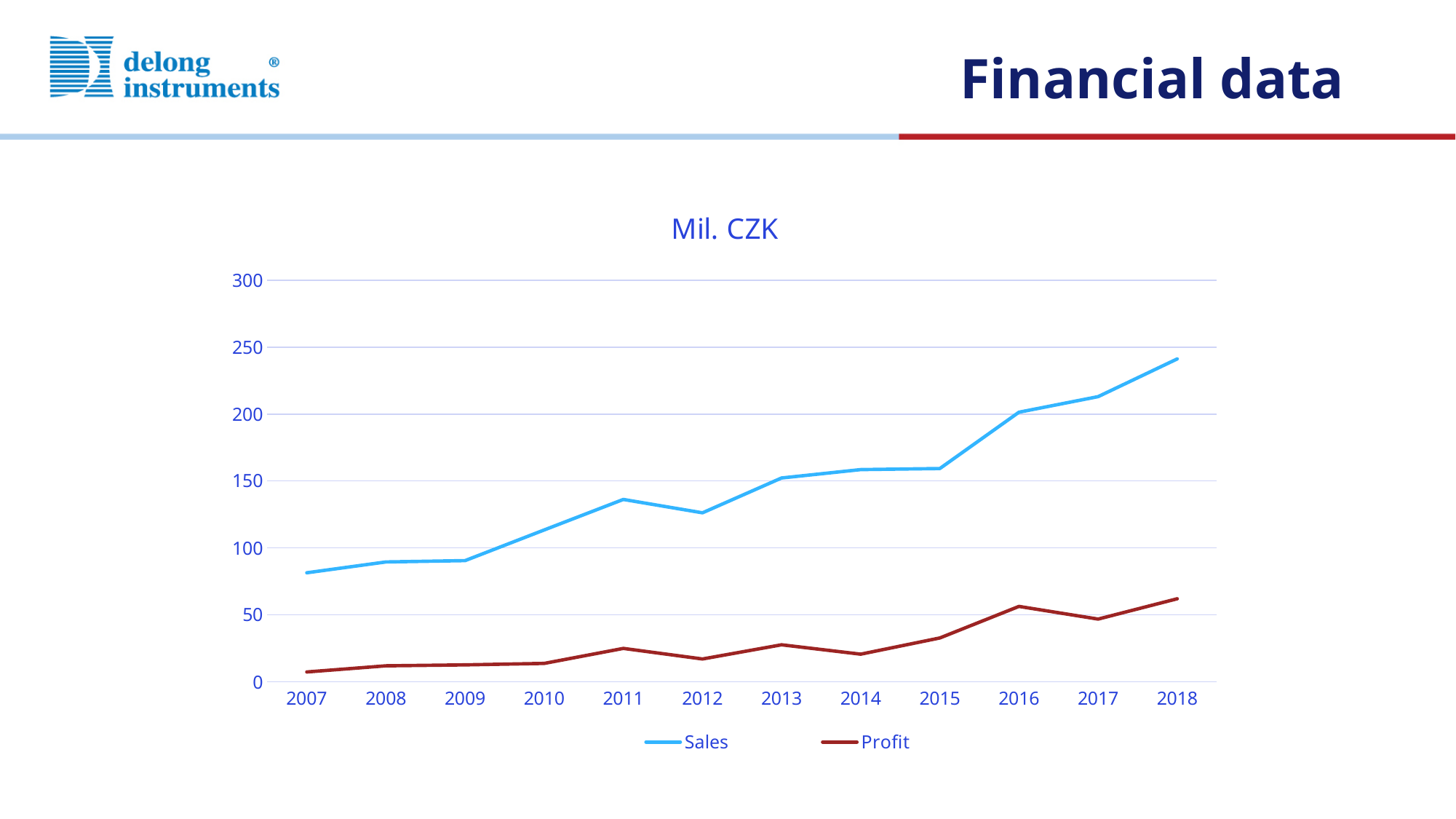
Is the value for Profit in 2016 greater or less than 50? greater Do Sales values generally rise or fall from 2007 to 2018? rise In which year is Sales lowest? 2007 In which year is Sales highest? 2018 Which is larger, Sales in 2011 or Sales in 2012? Sales in 2011 Is the value for Sales in 2007 greater or less than 100? less What kind of chart is shown on the slide? line chart How many years are shown on the x axis? 12 In which year is Profit lowest? 2007 Is the value for Sales in 2018 greater or less than 200? greater What is the title of the chart? Mil. CZK How many series does the legend list? 2